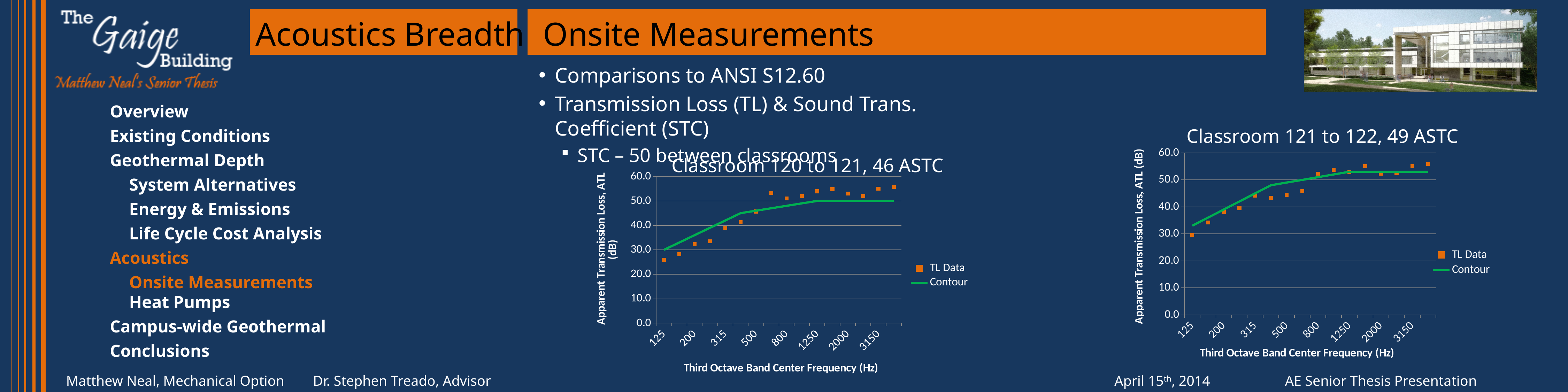
In the chart titled 'Classroom 120 to 121, 46 ASTC', is the TL Data value at 3150 Hz greater or less than 50.0? greater In the chart titled 'Classroom 120 to 121, 46 ASTC', do the TL Data values generally rise or fall as frequency increases along the x axis? rise In the chart titled 'Classroom 121 to 122, 49 ASTC', is the TL Data value at 3150 Hz greater or less than 50.0? greater In the chart titled 'Classroom 121 to 122, 49 ASTC', is the TL Data value at 315 Hz greater or less than 40.0? greater In the chart titled 'Classroom 120 to 121, 46 ASTC', which series is drawn as a green line? Contour In the chart titled 'Classroom 120 to 121, 46 ASTC', how many series does the legend list? 2 In the chart titled 'Classroom 121 to 122, 49 ASTC', does the Contour line rise or fall from 125 Hz to 3150 Hz? rise In the chart titled 'Classroom 121 to 122, 49 ASTC', what are the two legend entries? TL Data and Contour How many frequency labels are shown on the x axis of the chart titled 'Classroom 121 to 122, 49 ASTC'? 8 In the chart titled 'Classroom 120 to 121, 46 ASTC', what is the label of the y axis? Apparent Transmission Loss, ATL (dB)